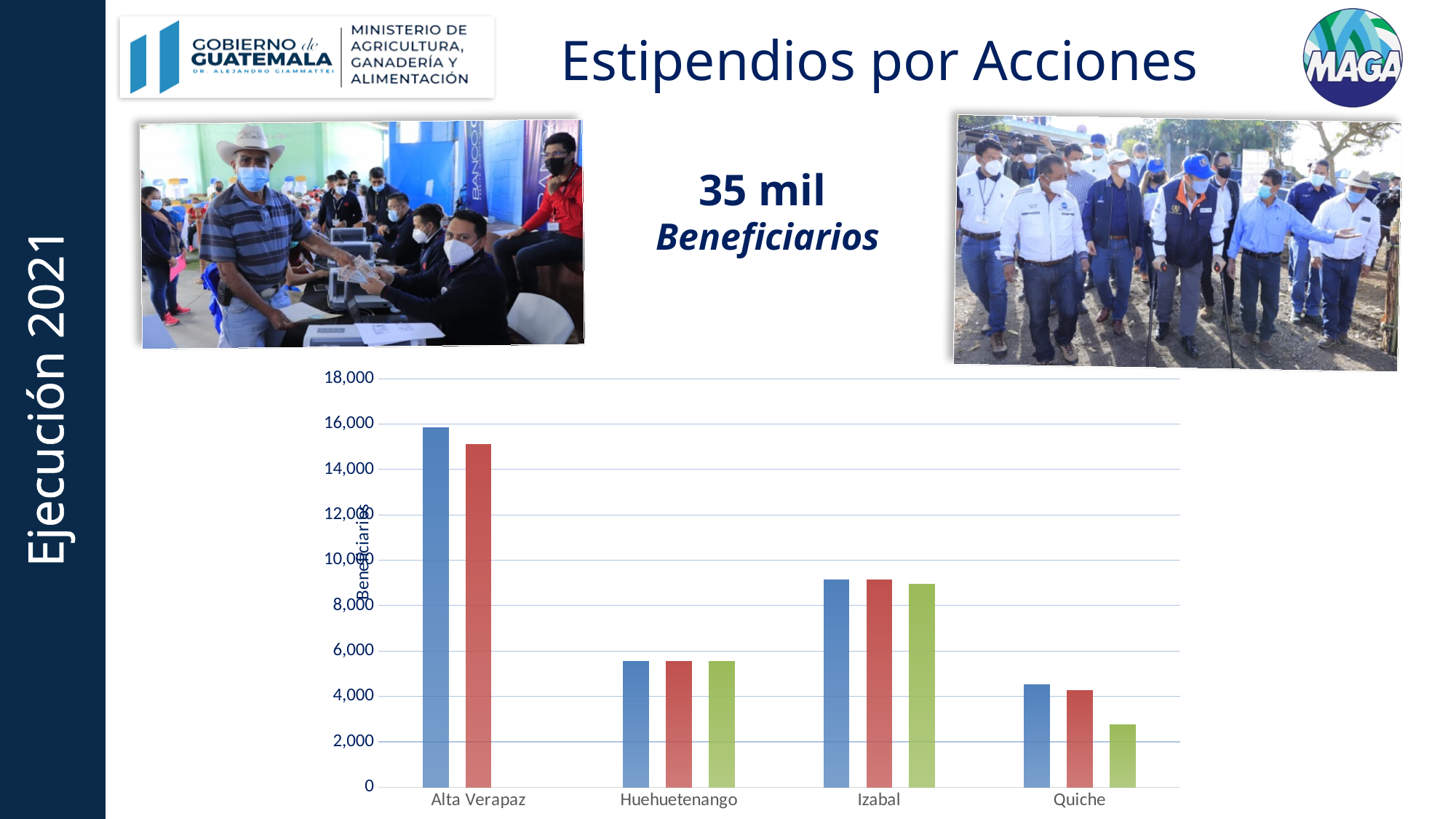
Is the value of the red bar for Izabal greater or less than 8,000? greater How many categories (departments) are shown on the x axis of the chart? 4 Which is larger: the blue bar for Izabal or the blue bar for Huehuetenango? Izabal What kind of chart is shown on the slide? bar chart Is the value of the blue bar for Huehuetenango greater or less than 6,000? less Is the value of the green bar for Quiche greater or less than 4,000? less How many bars are shown for Alta Verapaz? 2 Which category has the shortest bar in the chart? Quiche Which category has the tallest bar in the chart? Alta Verapaz What is the label on the vertical axis of the chart? Beneficiarios Which is larger for Quiche: the blue bar or the green bar? the blue bar